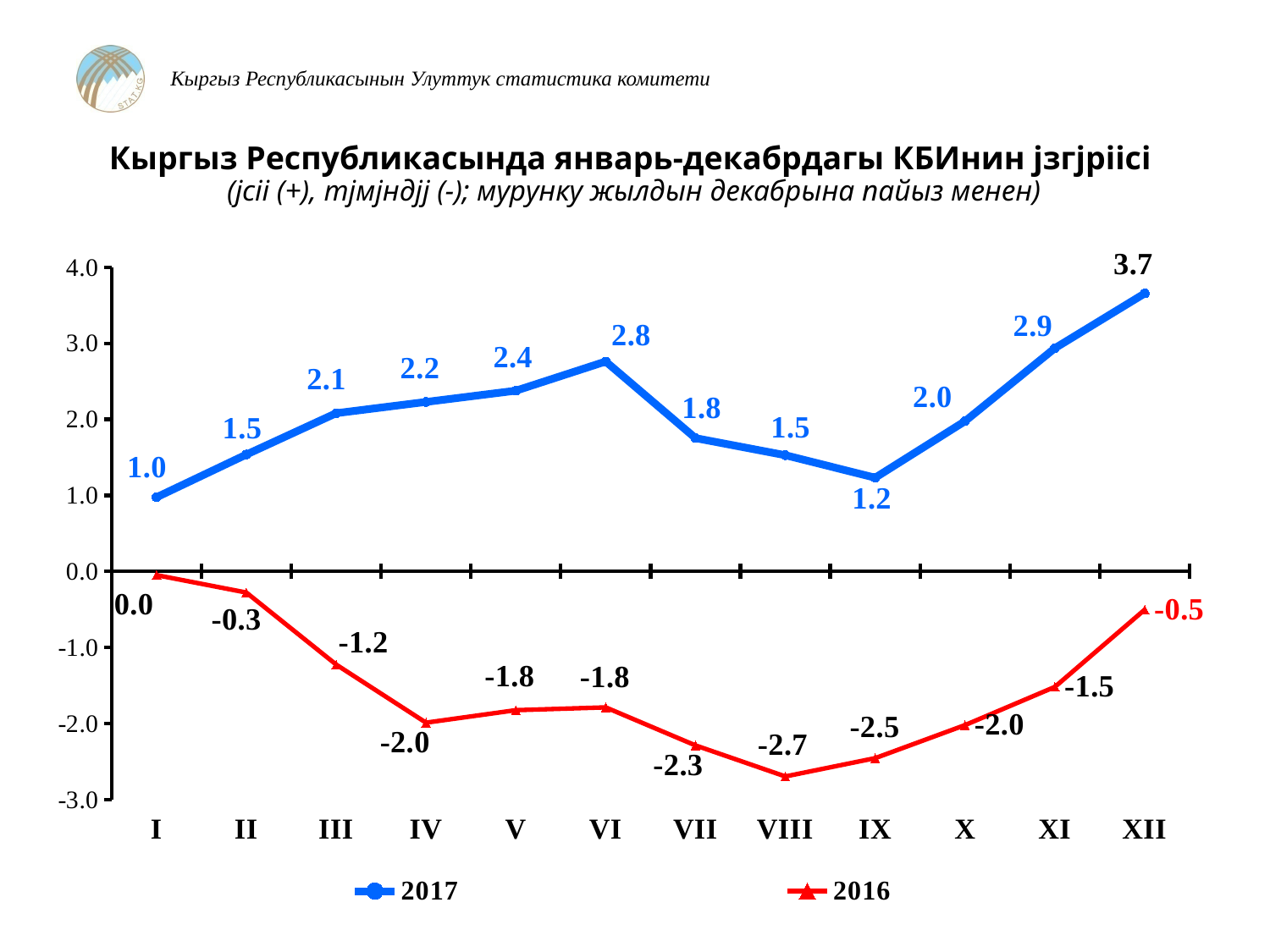
How many series does the legend list? 2 What kind of chart is shown on the slide? Line chart How many months are shown on the x axis? 12 Which series has the larger value in month IV, 2017 or 2016? 2017 In which month does the 2017 series have its lowest value? I What is the value for the 2017 series in month VI? 2.8 In which month does the 2017 series reach its highest value? XII Which colour is used for the 2016 series? Red What is the difference between the 2017 and 2016 values in month IX? 3.7 In which month does the 2016 series reach its lowest value? VIII What is the value for the 2016 series in month VIII? -2.7 What is the value for the 2017 series in month XII? 3.7